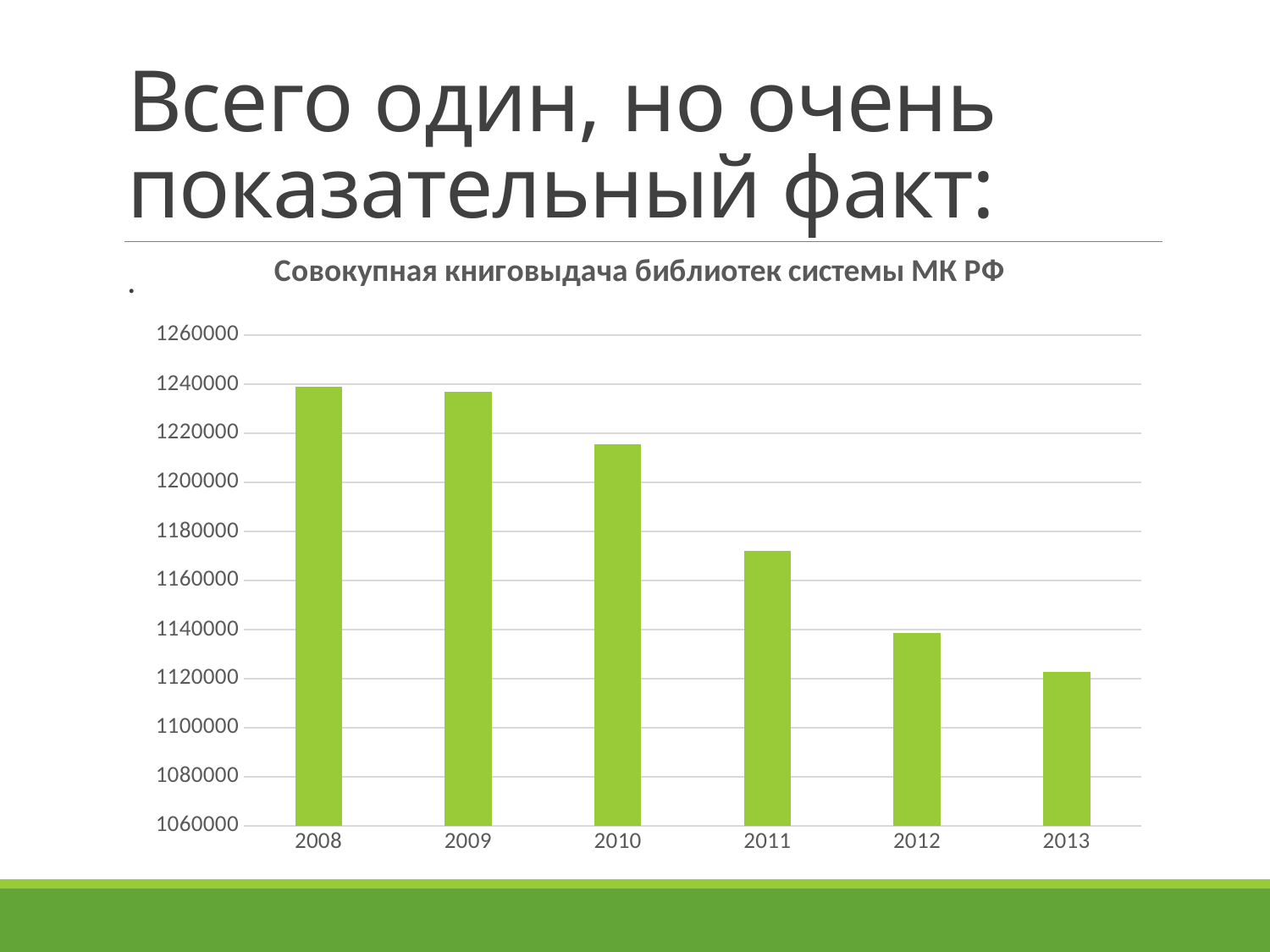
Is the value for 2011 greater or less than 1180000? less What kind of chart is shown on the slide? bar chart What is the title of the chart? Совокупная книговыдача библиотек системы МК РФ Is the value for 2008 greater or less than 1220000? greater Do the values rise or fall from 2008 to 2013? fall How many years are shown on the x axis of the chart? 6 What colour are the bars in the chart? green Is the value for 2013 greater or less than 1100000? greater Which year has the lowest value in the chart? 2013 Which year has the larger value, 2010 or 2011? 2010 Which year has the larger value, 2012 or 2013? 2012